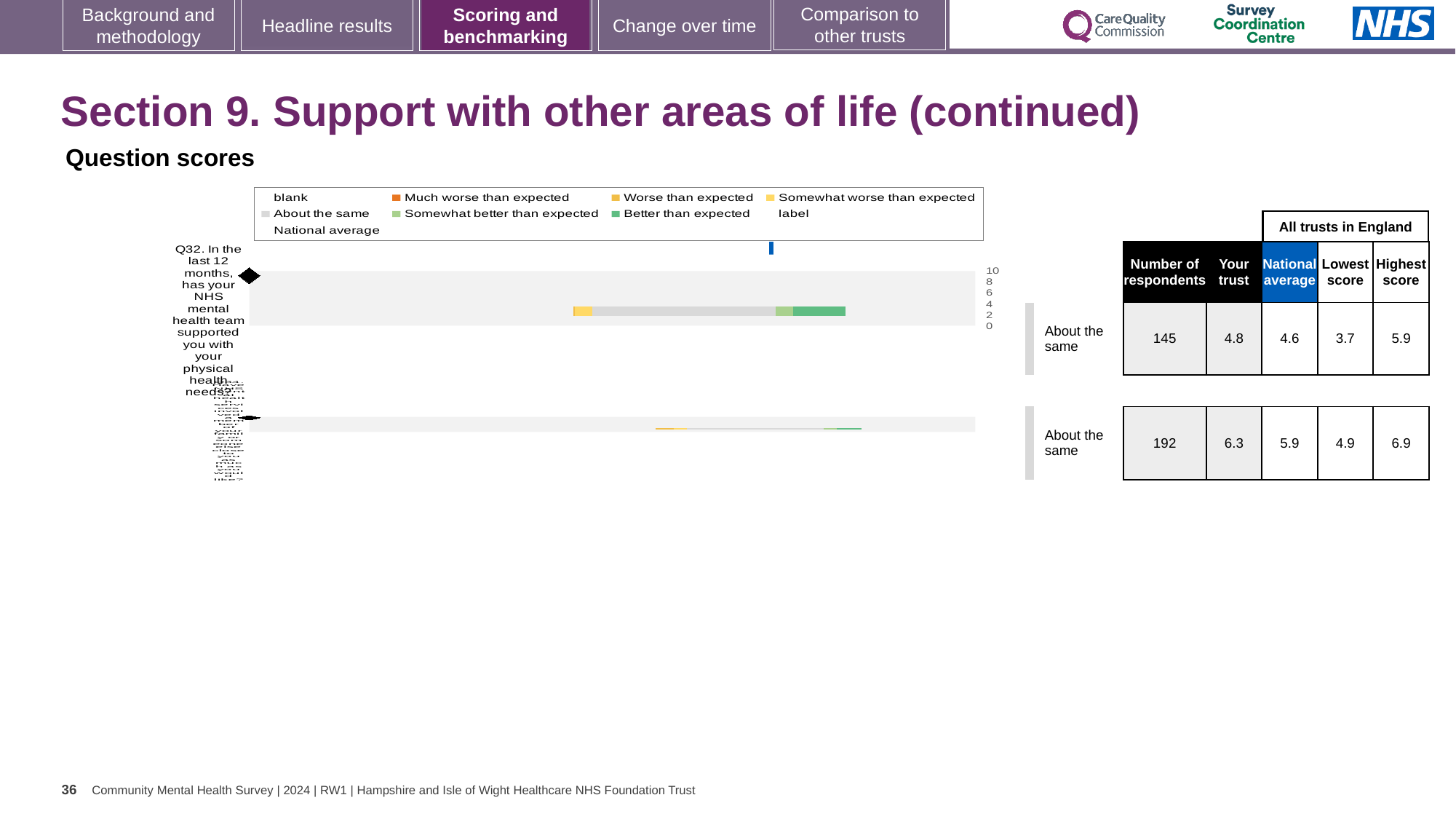
What kind of chart is shown on the slide? bar chart For Q32, which is larger: the 'Your trust' score or the national average? Your trust What is the highest tick value shown on the chart's axis? 10 What is the 'Your trust' score for Q32 in the table beside the chart? 4.8 What is the highest score among all trusts in England for the second question row in the table? 6.9 What is the national average score for Q32 in the table beside the chart? 4.6 For Q32, what is the difference between the 'Your trust' score and the national average? 0.2 According to the table beside the chart, how many respondents answered Q32? 145 How many question bars are plotted on the chart? 2 What is the lowest score among all trusts in England for Q32? 3.7 What benchmark category is shown for both question rows next to the chart? About the same How many entries does the chart's legend list? 9